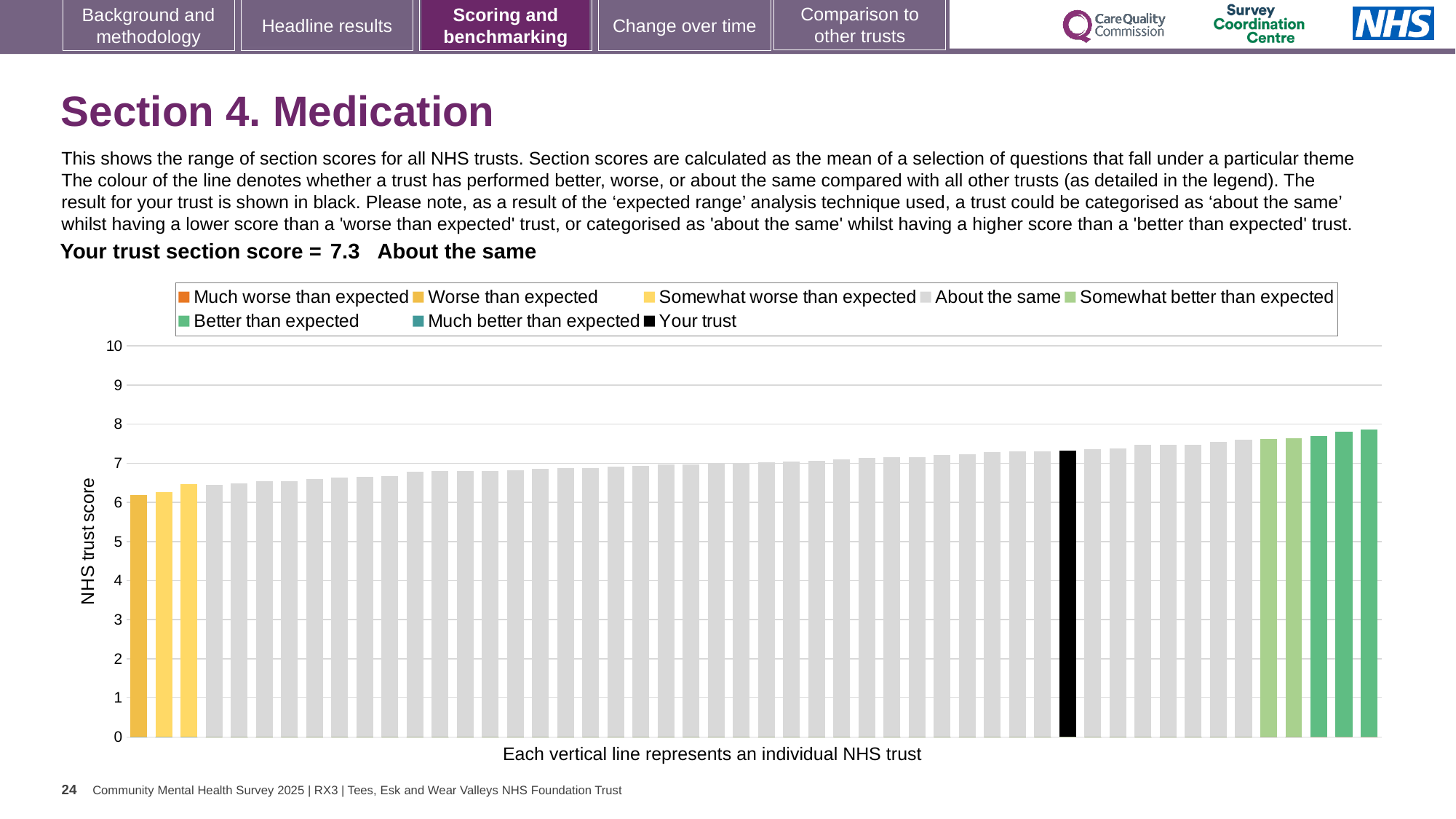
Is the value for your trust (the black bar) greater or less than 7? greater Is the value of the rightmost (highest) bar greater or less than 7? greater Which legend category does the highest bar on the chart belong to? Better than expected What is the section score for your trust shown on the slide? 7.3 Is the value of the leftmost (lowest) bar greater or less than 7? less How many entries does the chart legend list? 8 Which is larger: the value of the black 'Your trust' bar or the value of the leftmost bar? Your trust bar What is the title of the vertical axis? NHS trust score What kind of chart is shown on the slide? bar chart Do the bar values rise or fall from left to right along the x axis? rise According to the slide, which category does your trust's section score fall into? About the same